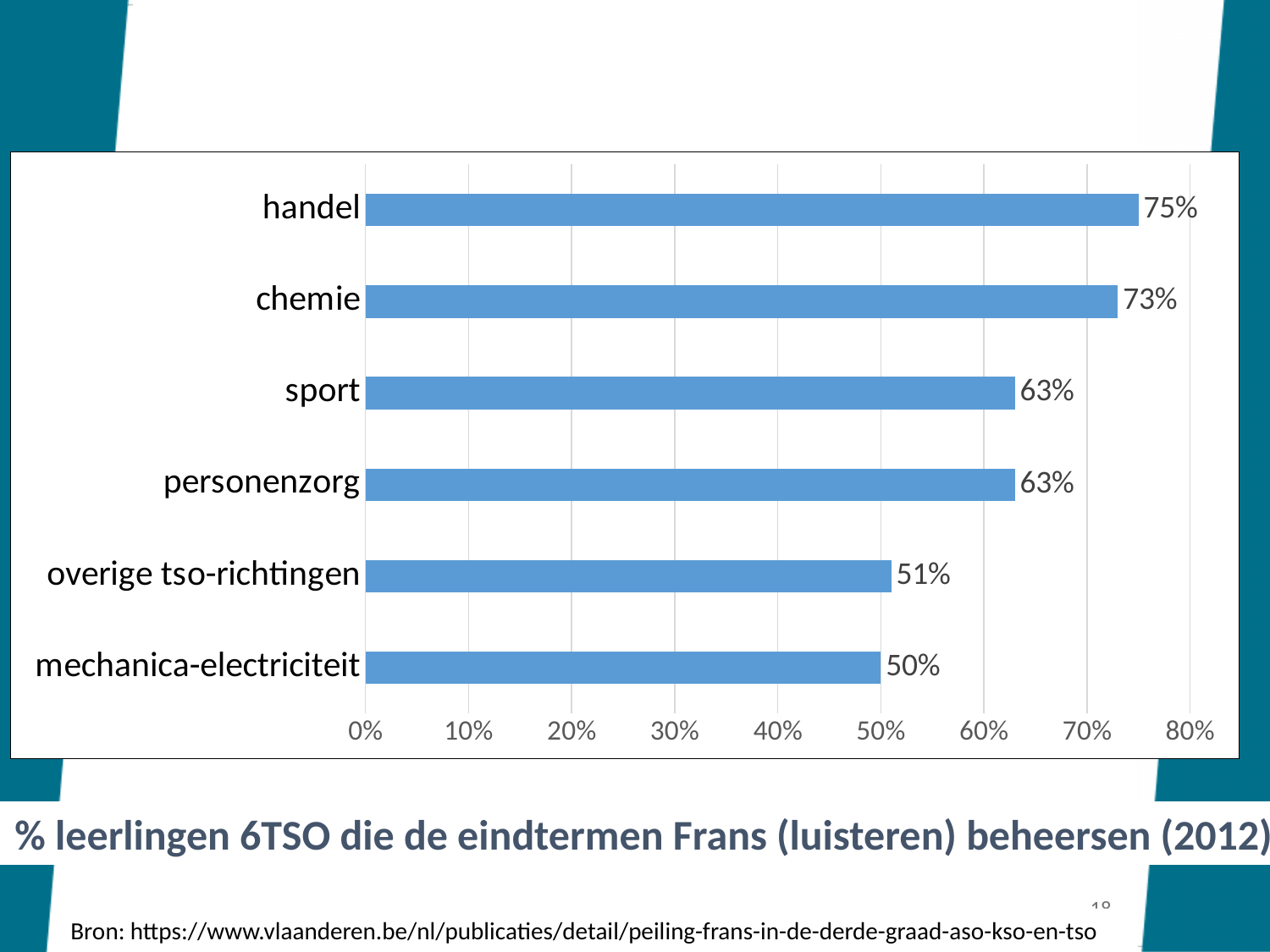
What is the value for handel? 75% What is the title shown below the chart? % leerlingen 6TSO die de eindtermen Frans (luisteren) beheersen (2012) What is the value for mechanica-electriciteit? 50% What is the difference between the values for handel and mechanica-electriciteit? 25% What is the value for overige tso-richtingen? 51% What is the difference between the values for chemie and sport? 10% How many categories are shown in the chart? 6 What kind of chart is shown on the slide? bar chart Which category has the highest value? handel Which category has the lowest value? mechanica-electriciteit Which is larger, the value for sport or the value for overige tso-richtingen? sport What is the value for chemie? 73%